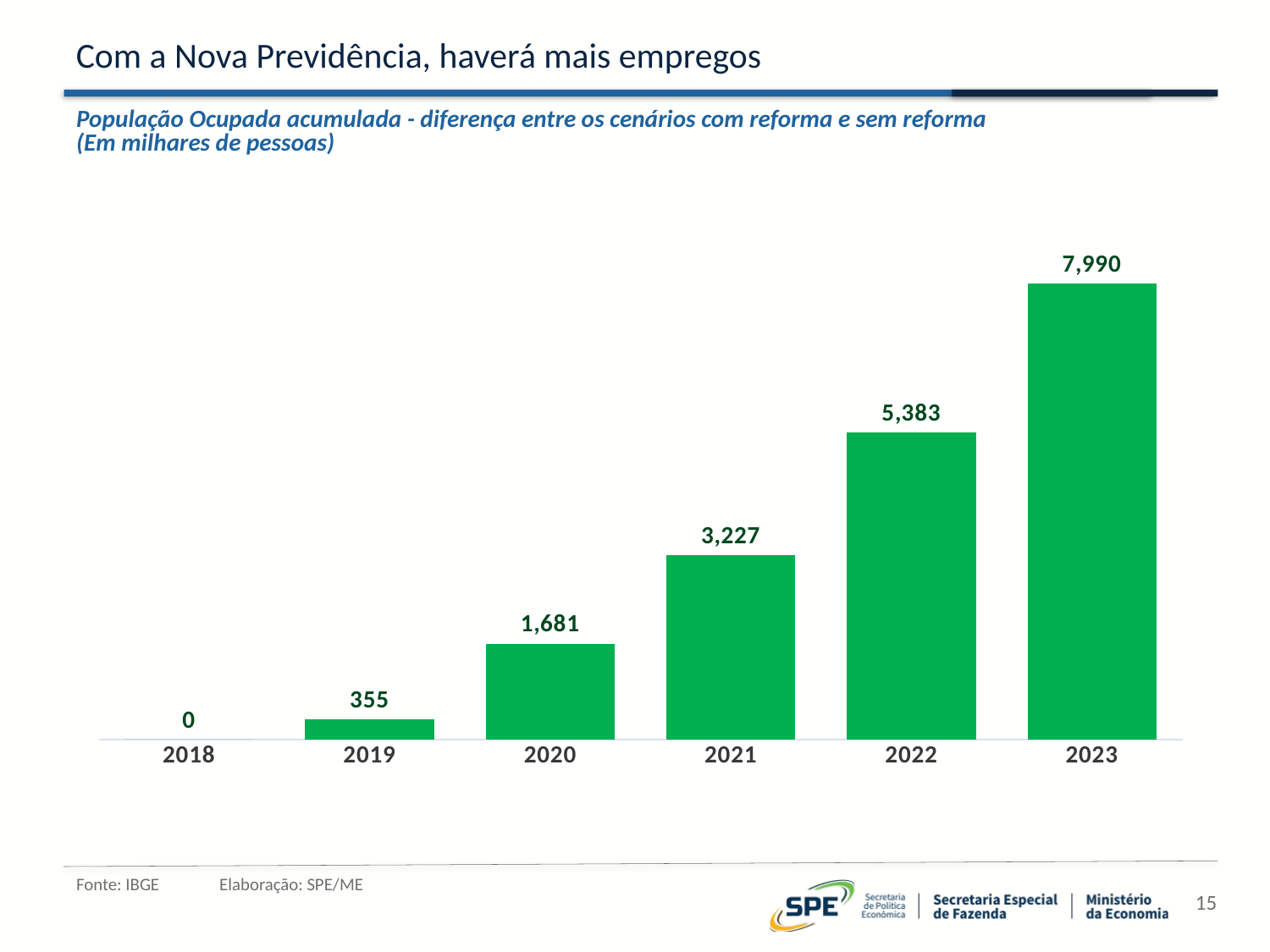
What is the value for 2021? 3,227 Which is larger, the value for 2021 or the value for 2022? 2022 Do the values rise or fall from 2018 to 2023? rise How many years are shown on the x axis? 6 What is the value for 2019? 355 Which year has the lowest value? 2018 What is the difference between the values for 2023 and 2022? 2,607 What is the value for 2023? 7,990 In what unit are the values expressed, according to the chart subtitle? Em milhares de pessoas What is the difference between the values for 2020 and 2019? 1,326 What kind of chart is shown on the slide? bar chart Which year has the highest value? 2023